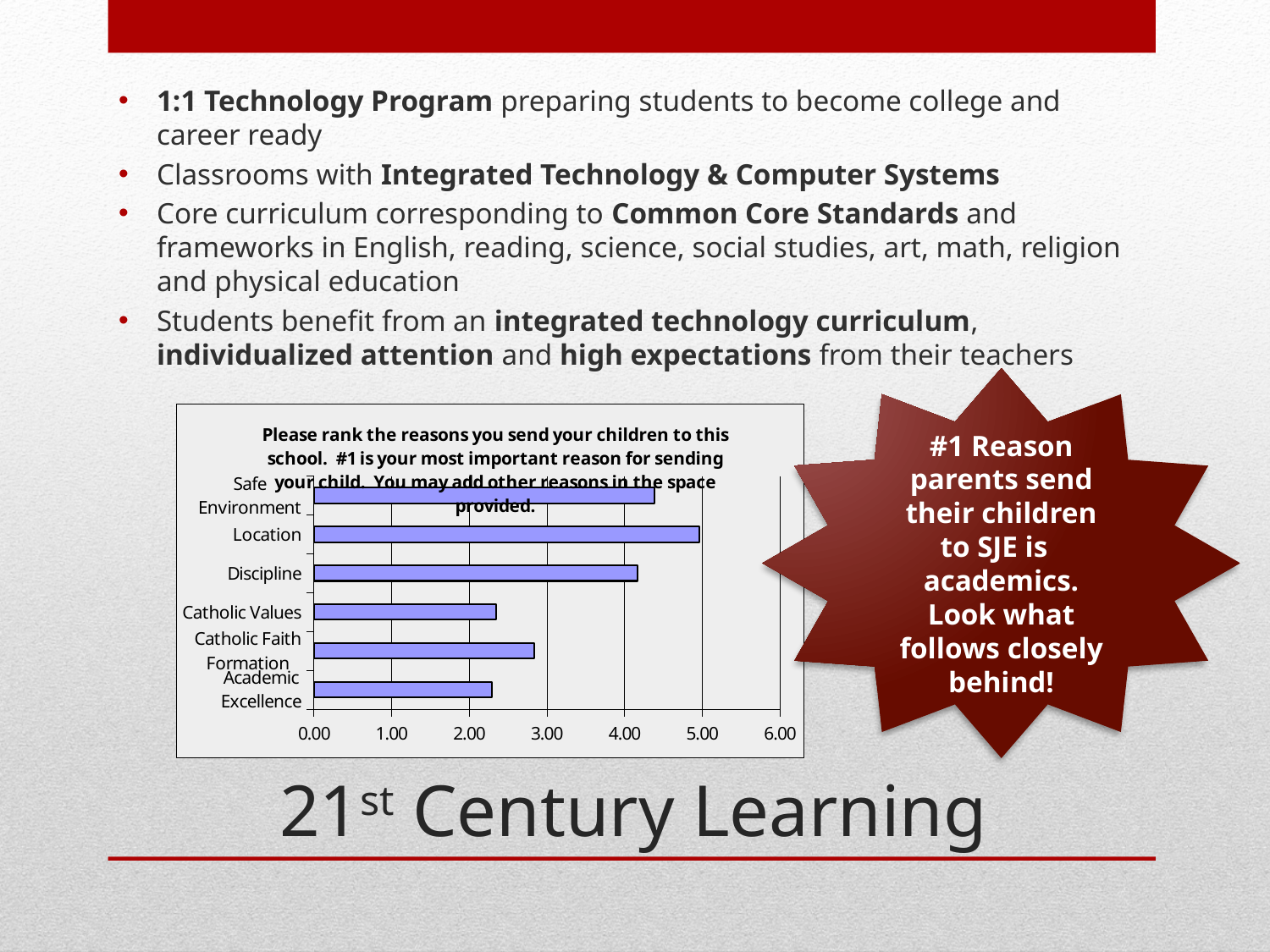
Is the value for Discipline greater or less than 3.00? greater Which has the larger value, Safe Environment or Catholic Values? Safe Environment What kind of chart is shown on the slide? bar chart Is the value for Location greater or less than 4.00? greater Is the value for Safe Environment greater or less than 4.00? greater Which category has the longest bar in the chart? Location Which has the larger value, Catholic Faith Formation or Academic Excellence? Catholic Faith Formation Which has the larger value, Location or Discipline? Location How many categories are plotted in the bar chart? 6 What is the highest value shown on the chart's horizontal axis? 6.00